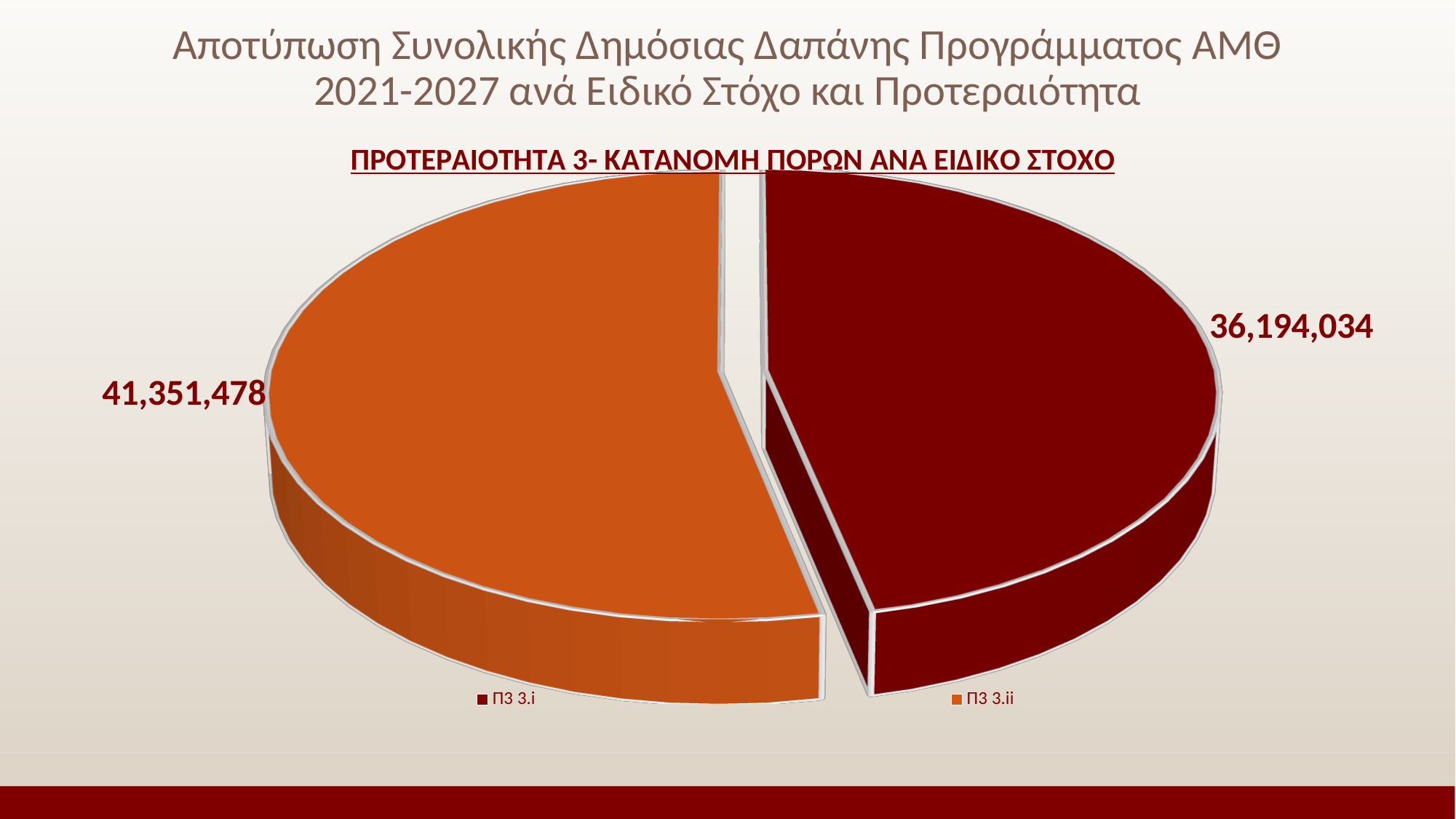
Which category has the largest slice of the pie? Π3 3.ii What is the value for Π3 3.i? 36,194,034 How many slices does the pie chart have? 2 What is the total of the two slices in the pie chart? 77,545,512 What is the title of the pie chart? ΠΡΟΤΕΡΑΙΟΤΗΤΑ 3- ΚΑΤΑΝΟΜΗ ΠΟΡΩΝ ΑΝΑ ΕΙΔΙΚΟ ΣΤΟΧΟ What is the difference between the values for Π3 3.ii and Π3 3.i? 5,157,444 What kind of chart is shown on the slide? Pie chart Which category has the smallest slice of the pie? Π3 3.i Which colour represents Π3 3.ii in the pie chart? Orange How many entries does the legend list? 2 What is the value for Π3 3.ii? 41,351,478 Which is larger, the value for Π3 3.i or the value for Π3 3.ii? Π3 3.ii